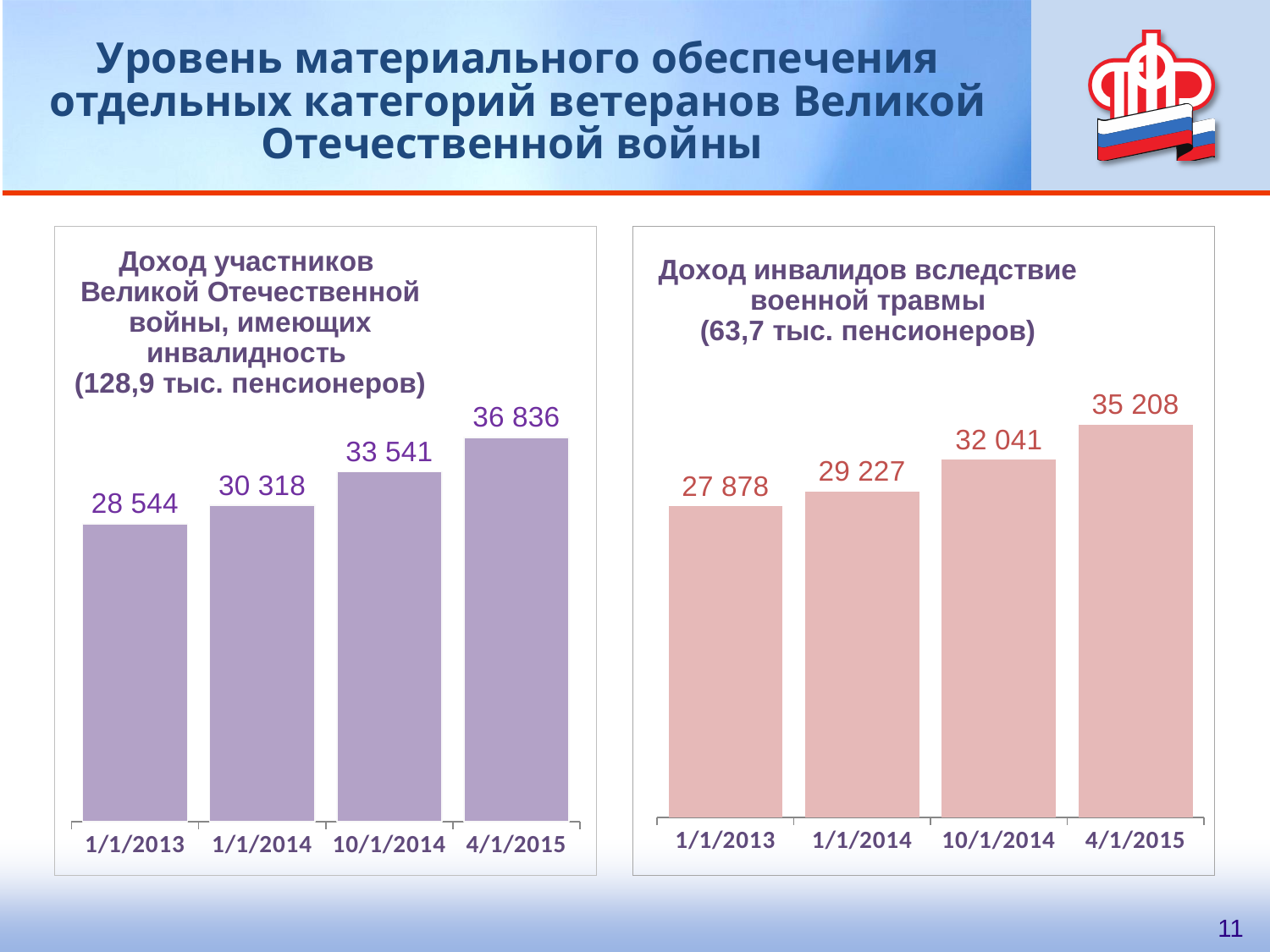
In the left chart (Доход участников Великой Отечественной войны, имеющих инвалидность), what is the value for 1/1/2013? 28 544 How many dates are shown on the x axis of the right chart (Доход инвалидов вследствие военной травмы)? 4 In the right chart (Доход инвалидов вследствие военной травмы), do the values rise or fall from 1/1/2013 to 4/1/2015? Rise In the left chart (Доход участников Великой Отечественной войны, имеющих инвалидность), what is the difference between the values for 4/1/2015 and 1/1/2013? 8 292 Which is larger: the value for 1/1/2014 in the left chart or the value for 1/1/2014 in the right chart? The left chart (30 318) In the left chart (Доход участников Великой Отечественной войны, имеющих инвалидность), what is the value for 4/1/2015? 36 836 What type of chart is the left chart (Доход участников Великой Отечественной войны, имеющих инвалидность)? Bar chart In the right chart (Доход инвалидов вследствие военной травмы), what is the value for 1/1/2014? 29 227 In the right chart (Доход инвалидов вследствие военной травмы), what is the difference between the values for 4/1/2015 and 10/1/2014? 3 167 In the right chart (Доход инвалидов вследствие военной травмы), which date has the lowest value? 1/1/2013 In the right chart (Доход инвалидов вследствие военной травмы), what is the value for 10/1/2014? 32 041 In the left chart (Доход участников Великой Отечественной войны, имеющих инвалидность), which date has the highest value? 4/1/2015